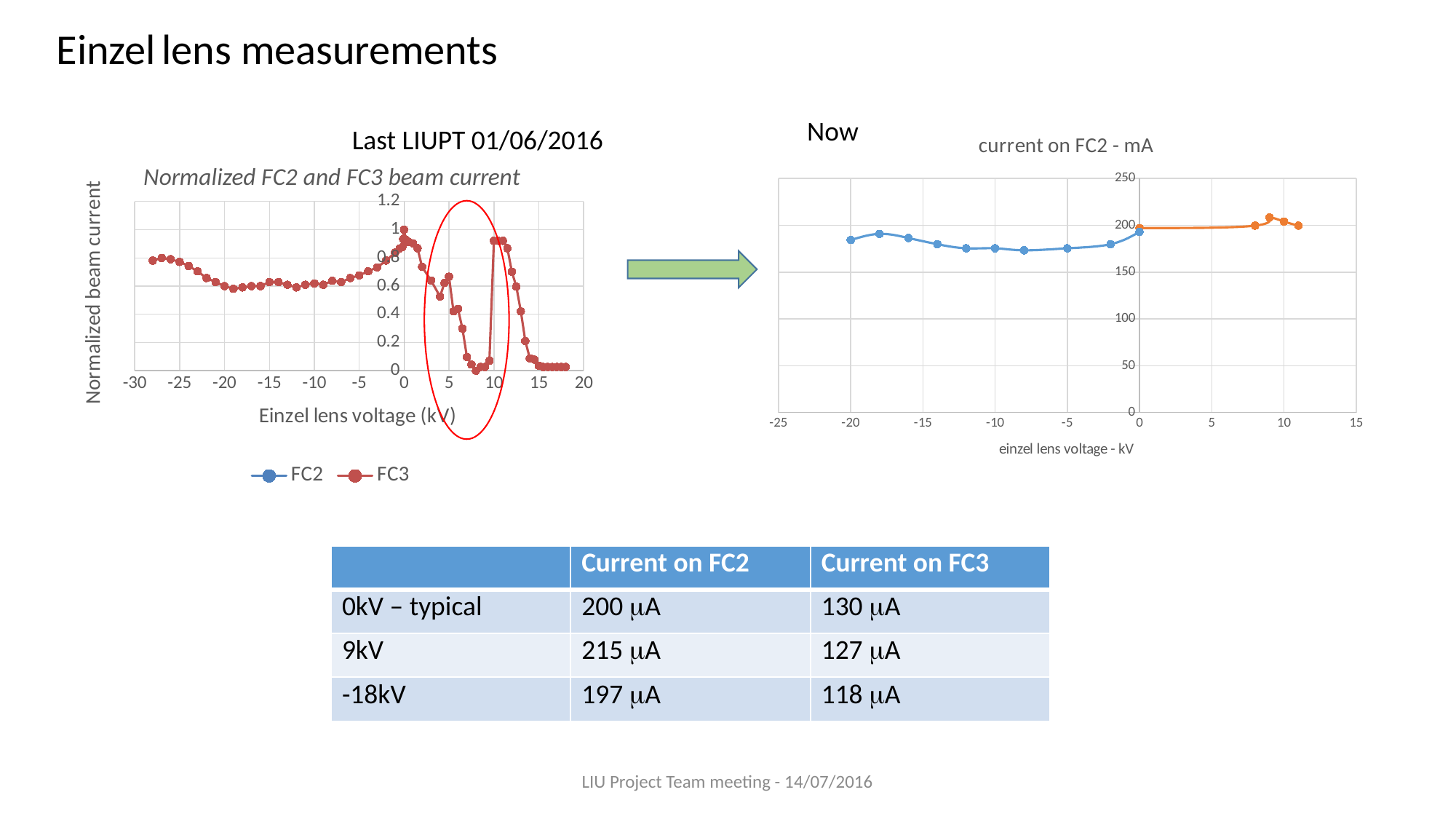
What kind of chart is the 'current on FC2 - mA' chart on the right? line chart In the 'Normalized FC2 and FC3 beam current' chart, is the value at 0 kV greater or less than 0.8? greater What are the two legend entries of the chart on the left? FC2 and FC3 In the 'current on FC2 - mA' chart, is the value at -20 kV greater or less than 150? greater What is the x-axis label of the 'current on FC2 - mA' chart? einzel lens voltage - kV How many series does the legend of the 'Normalized FC2 and FC3 beam current' chart list? 2 In the 'Normalized FC2 and FC3 beam current' chart, is the value at 8 kV greater or less than 0.2? less In the 'current on FC2 - mA' chart, do the values rise or fall between -8 kV and 0 kV? rise What kind of chart is the 'Normalized FC2 and FC3 beam current' chart on the left? line chart In the 'Normalized FC2 and FC3 beam current' chart, do the values rise or fall between 12 kV and 18 kV? fall